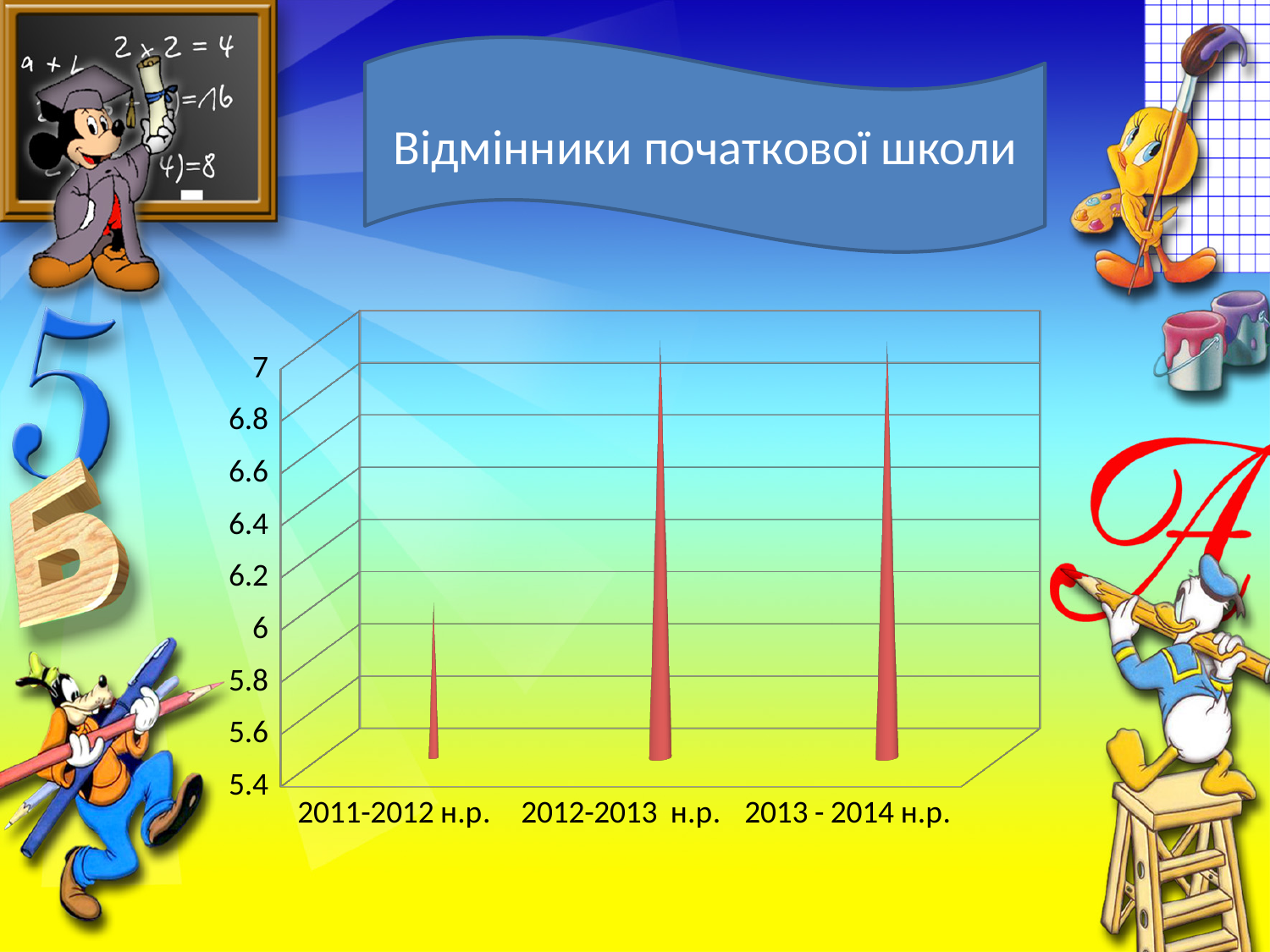
Which is larger, the value for 2011-2012 н.р. or the value for 2012-2013 н.р.? 2012-2013 н.р. How many categories are shown on the x axis of the chart? 3 Is the value for 2012-2013 н.р. greater or less than 6.4? greater Is the value for 2011-2012 н.р. greater or less than 5.6? greater What kind of chart is shown on the slide? bar chart Is the value for 2011-2012 н.р. greater or less than 6.4? less What is the lowest value shown on the vertical axis of the chart? 5.4 Which category has the lowest value in the chart? 2011-2012 н.р. What is the title of the chart on the slide? Відмінники початкової школи Does the value rise or fall from 2011-2012 н.р. to 2012-2013 н.р.? rise